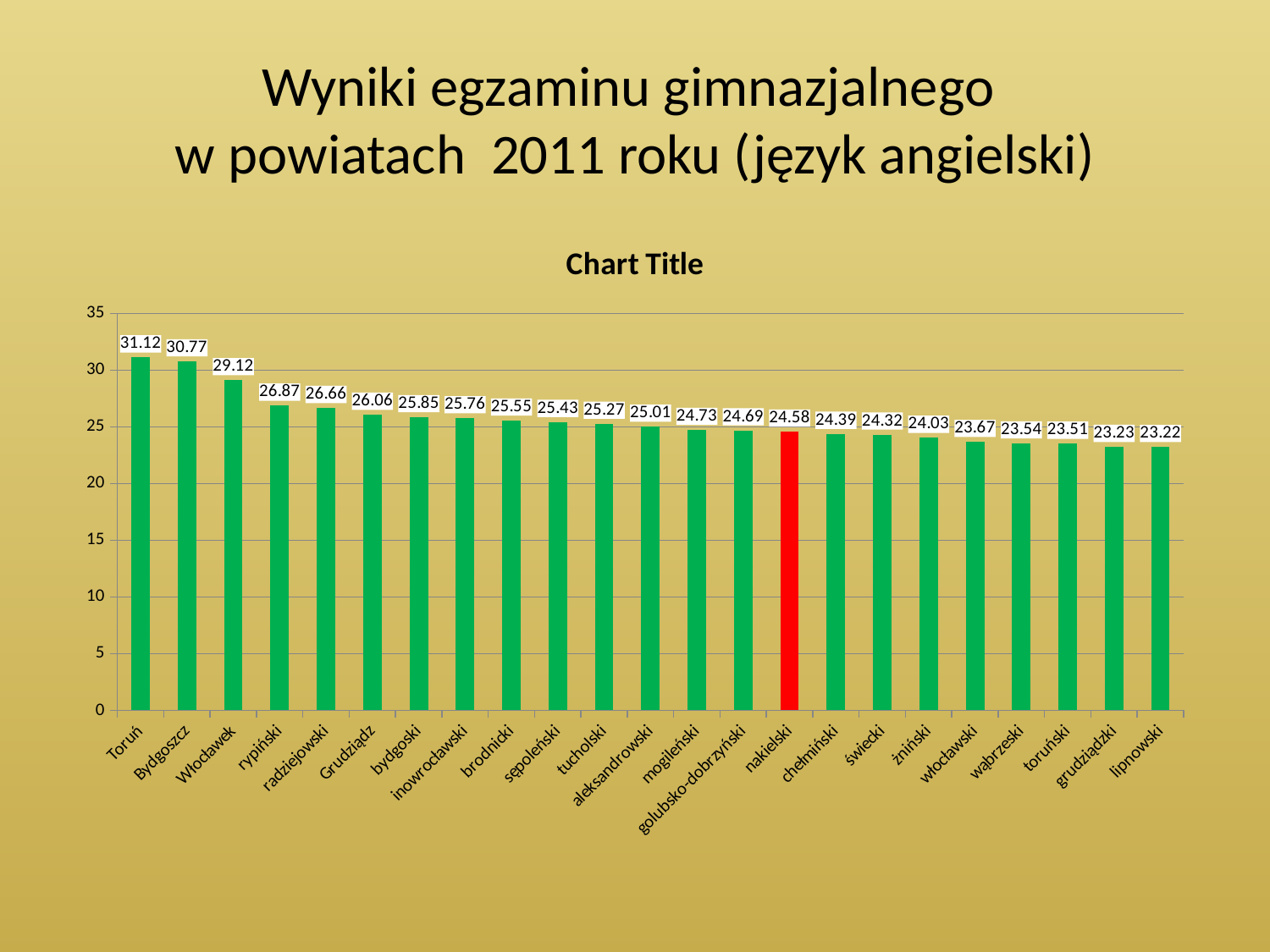
Which category has the lowest value? lipnowski What is the value for nakielski? 24.58 What is the value for Grudziądz? 26.06 How many categories are shown on the x axis? 23 Which category's bar is coloured red instead of green? nakielski Is the value for chełmiński greater or less than 25? less What kind of chart is shown on the slide? bar chart What is the value for Toruń? 31.12 Which is larger, the value for Włocławek or the value for rypiński? Włocławek Which category has the highest value? Toruń What is the difference between the values for Toruń and Bydgoszcz? 0.35 What is the value for lipnowski? 23.22